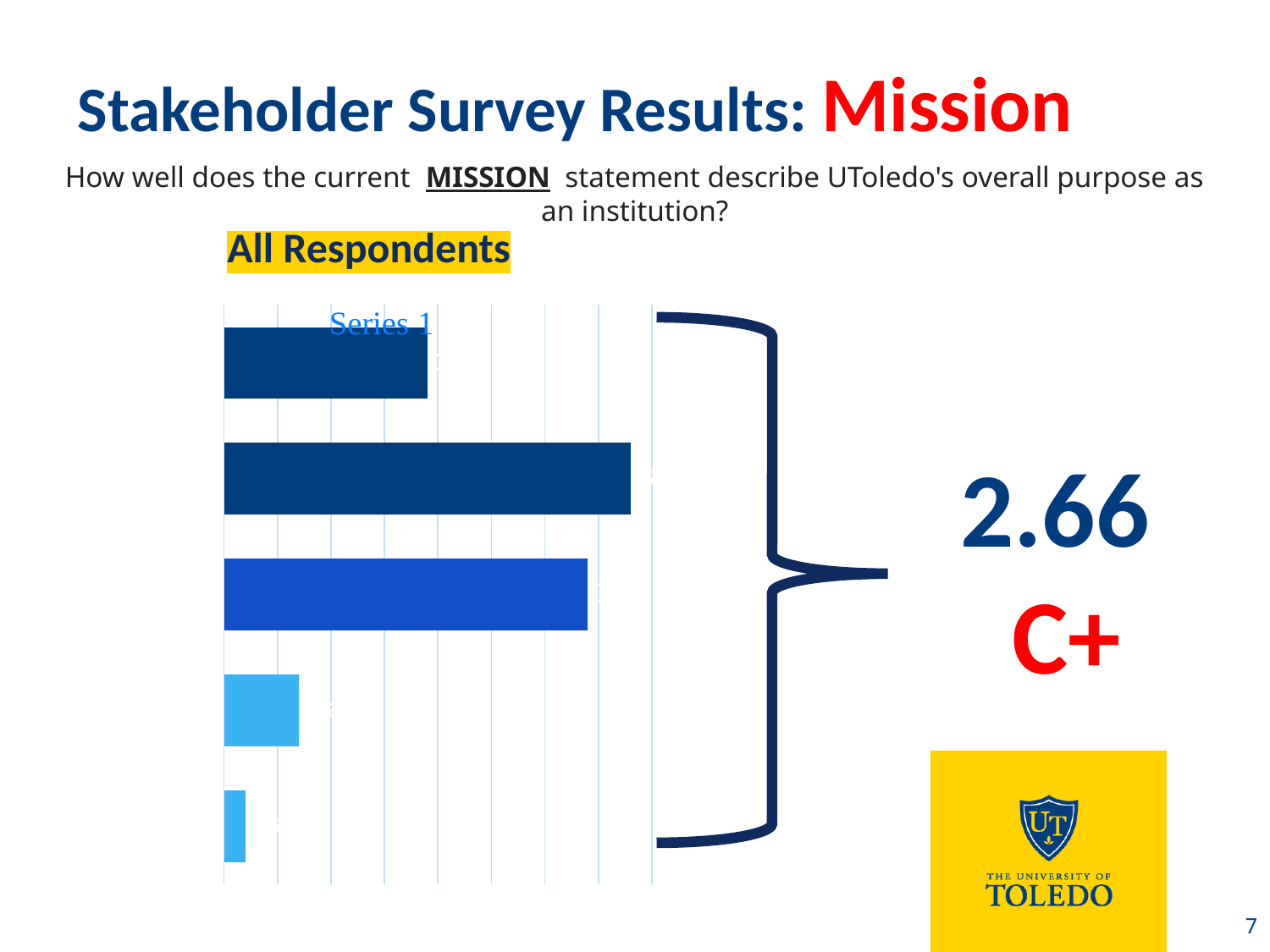
Are the bars in the chart drawn horizontally or vertically? horizontally Counting from the top, which bar in the chart is the shortest? the fifth (bottom) bar What title is printed at the top of the chart? Series 1 How many bars does the chart contain? 5 Is the bottom bar of the chart longer or shorter than the fourth bar from the top? shorter Is the top bar of the chart longer or shorter than the second bar from the top? shorter Is the third bar from the top longer or shorter than the fourth bar from the top? longer Counting from the top, which bar in the chart is the longest? the second bar What kind of chart is shown on the slide? bar chart